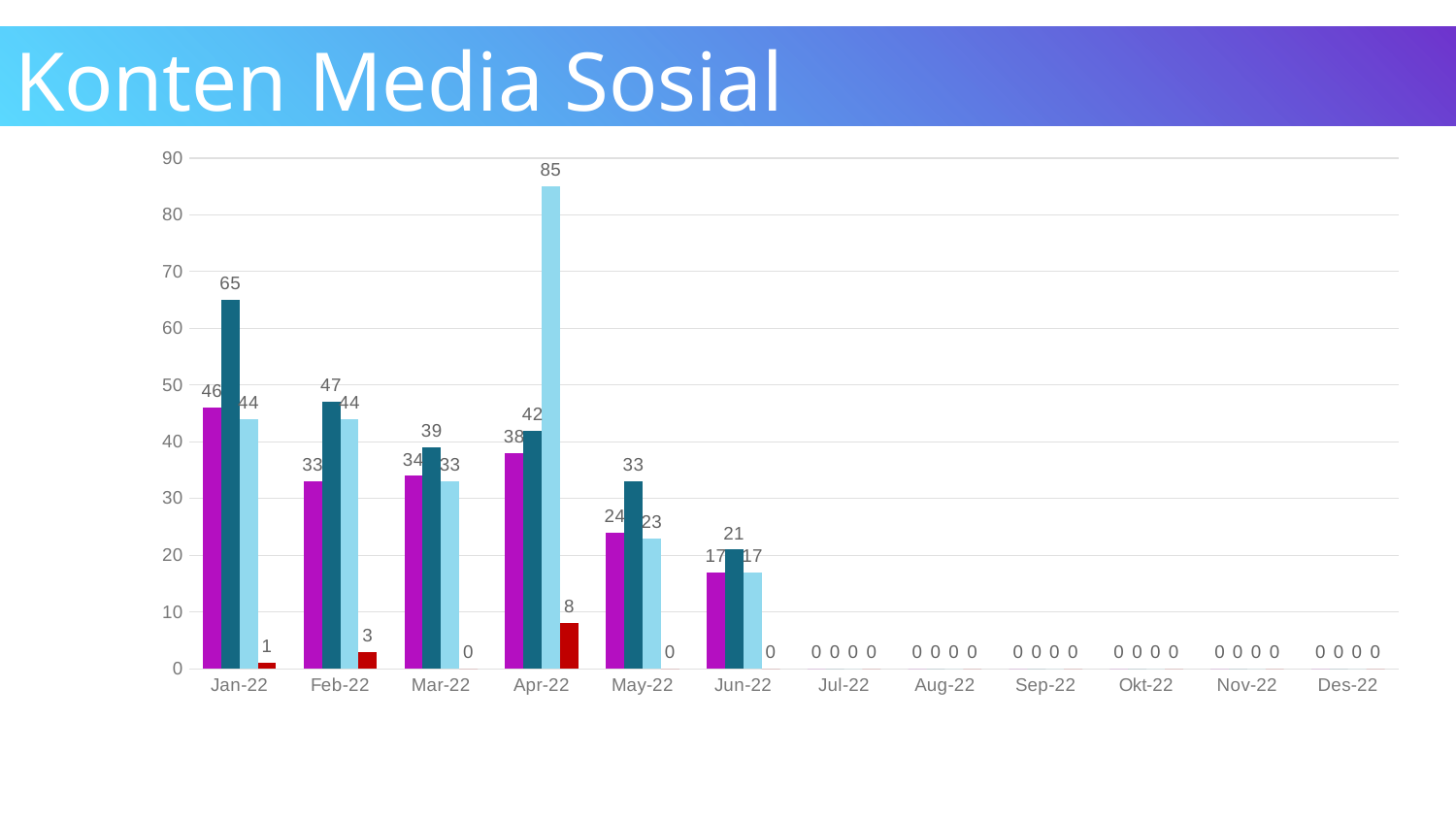
In which month is the dark teal bar highest? Jan-22 What is the title of the chart? Konten Media Sosial What kind of chart is shown on the slide? bar chart What is the value of the dark teal bar for Jan-22? 65 For Feb-22, which is larger: the dark teal bar or the light blue bar? dark teal bar Which month has the tallest bar in the chart? Apr-22 Do the dark teal bars rise or fall from Apr-22 to Jun-22? fall What is the value of the red bar for Apr-22? 8 How many months are shown on the x axis of the chart? 12 What is the value of the light blue bar for Apr-22? 85 What is the difference between the dark teal bar and the magenta bar for Jan-22? 19 What is the value of the magenta bar for May-22? 24